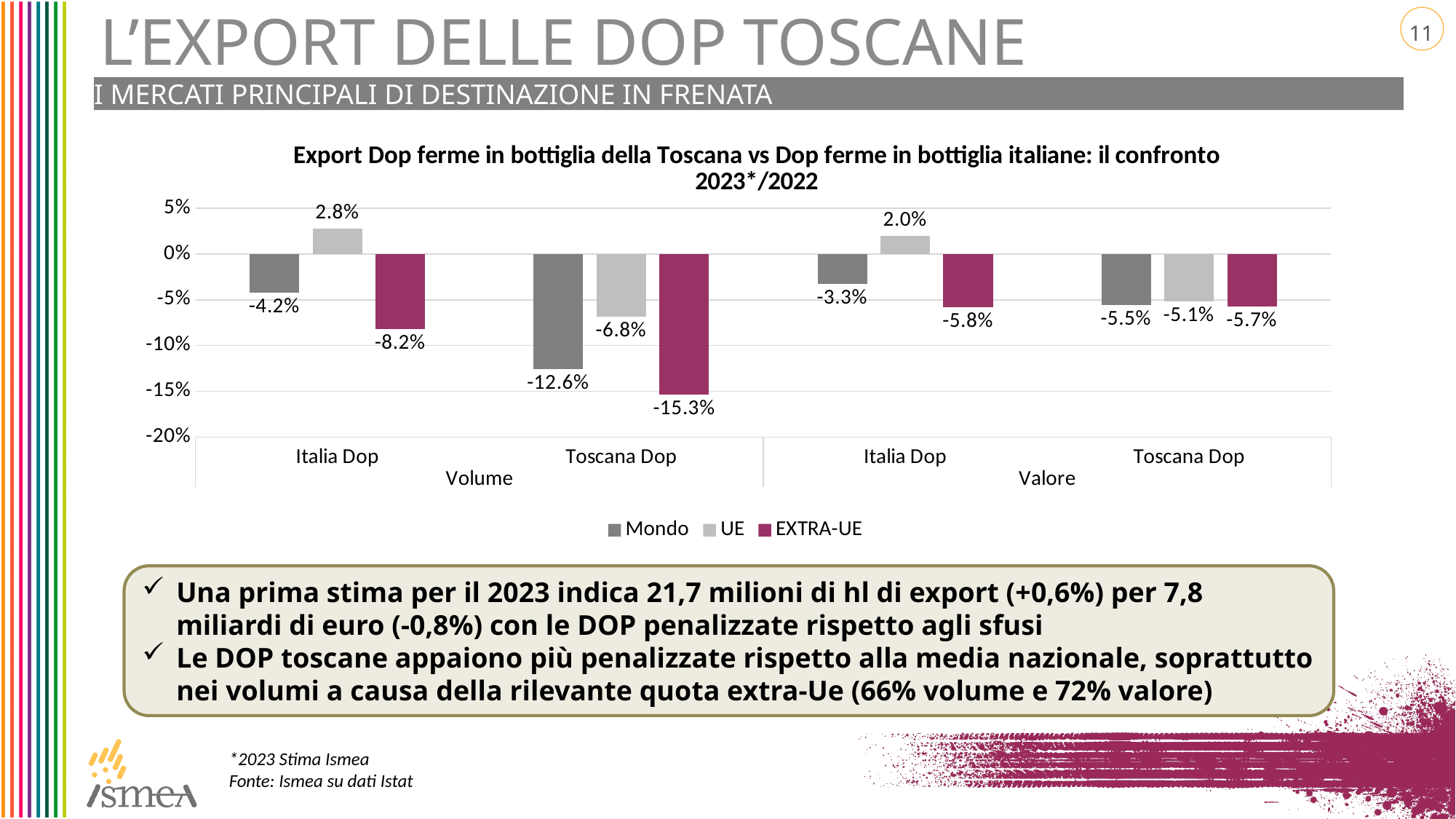
What is the EXTRA-UE value for Toscana Dop in the Volume section? -15.3% In the Volume section, is the EXTRA-UE value for Italia Dop or for Toscana Dop lower? Toscana Dop Which bar in the chart has the lowest value? EXTRA-UE, Toscana Dop (Volume) How many series does the legend list? 3 How many category groups are shown on the x axis? 4 What is the UE value for Italia Dop in the Valore section? 2.0% Which bar in the chart has the highest value? UE, Italia Dop (Volume) What kind of chart is shown on the slide? Bar chart What is the Mondo value for Toscana Dop in the Valore section? -5.5% What is the difference between the Mondo values for Toscana Dop and Italia Dop in the Volume section? 8.4 percentage points Which series is shown in dark magenta in the legend? EXTRA-UE What is the UE value for Italia Dop in the Volume section? 2.8%